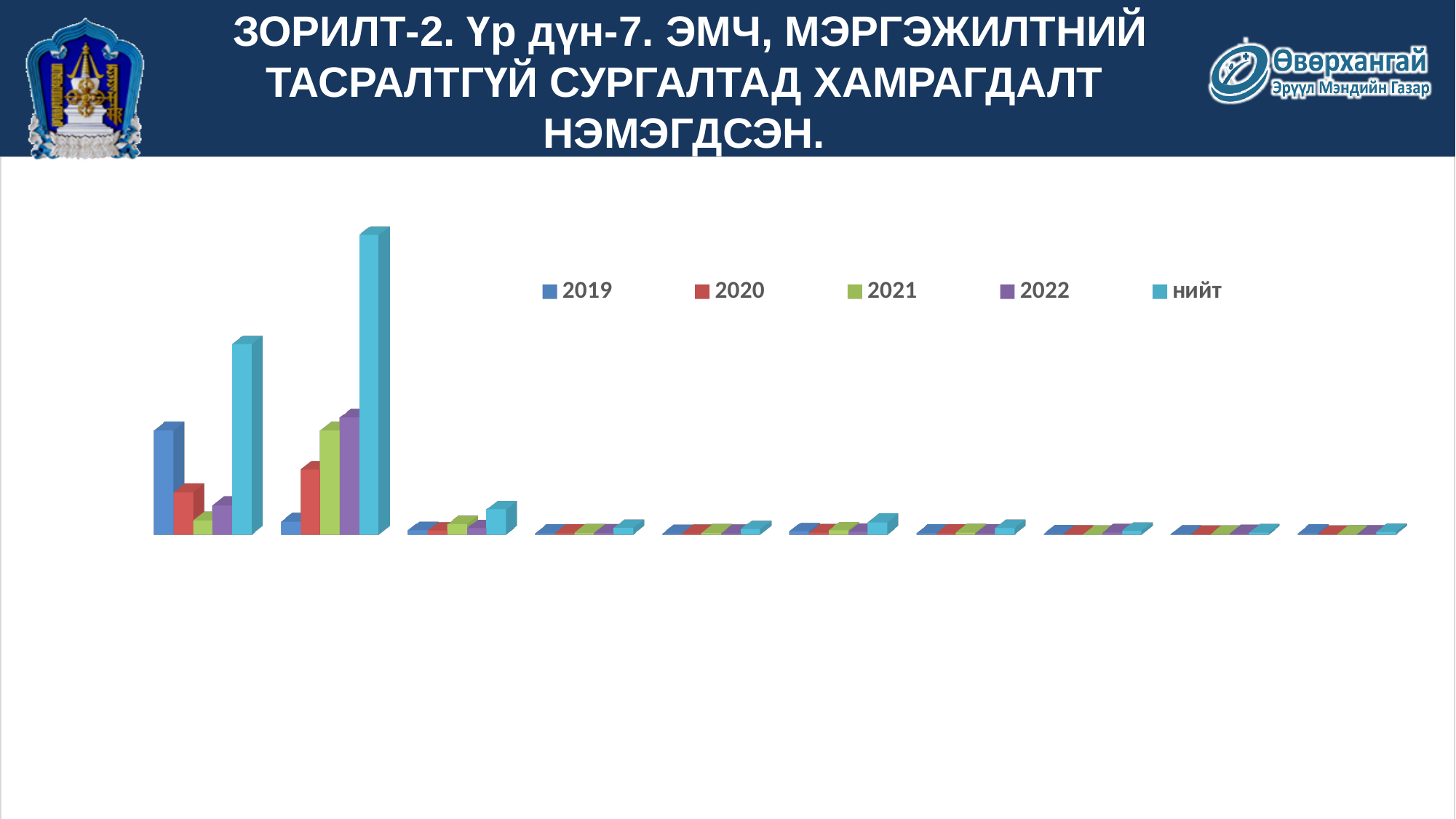
What are the series names listed in the chart legend? 2019, 2020, 2021, 2022, нийт How many series does the chart legend list? 5 Which group of bars from the left contains the tallest bar in the whole chart? the second group Which colour represents the series нийт in the chart? light blue What kind of chart is shown on the slide? bar chart In the first group of bars from the left, which series has the shortest bar? 2021 In the second group of bars from the left, which series has the tallest bar? нийт How many groups of bars (categories) are plotted in the chart? 10 In the first group of bars from the left, which series has the tallest bar? нийт In the first group of bars from the left, which is larger, the 2019 bar or the 2020 bar? 2019 In the second group of bars from the left, which is larger, the 2019 bar or the 2022 bar? 2022